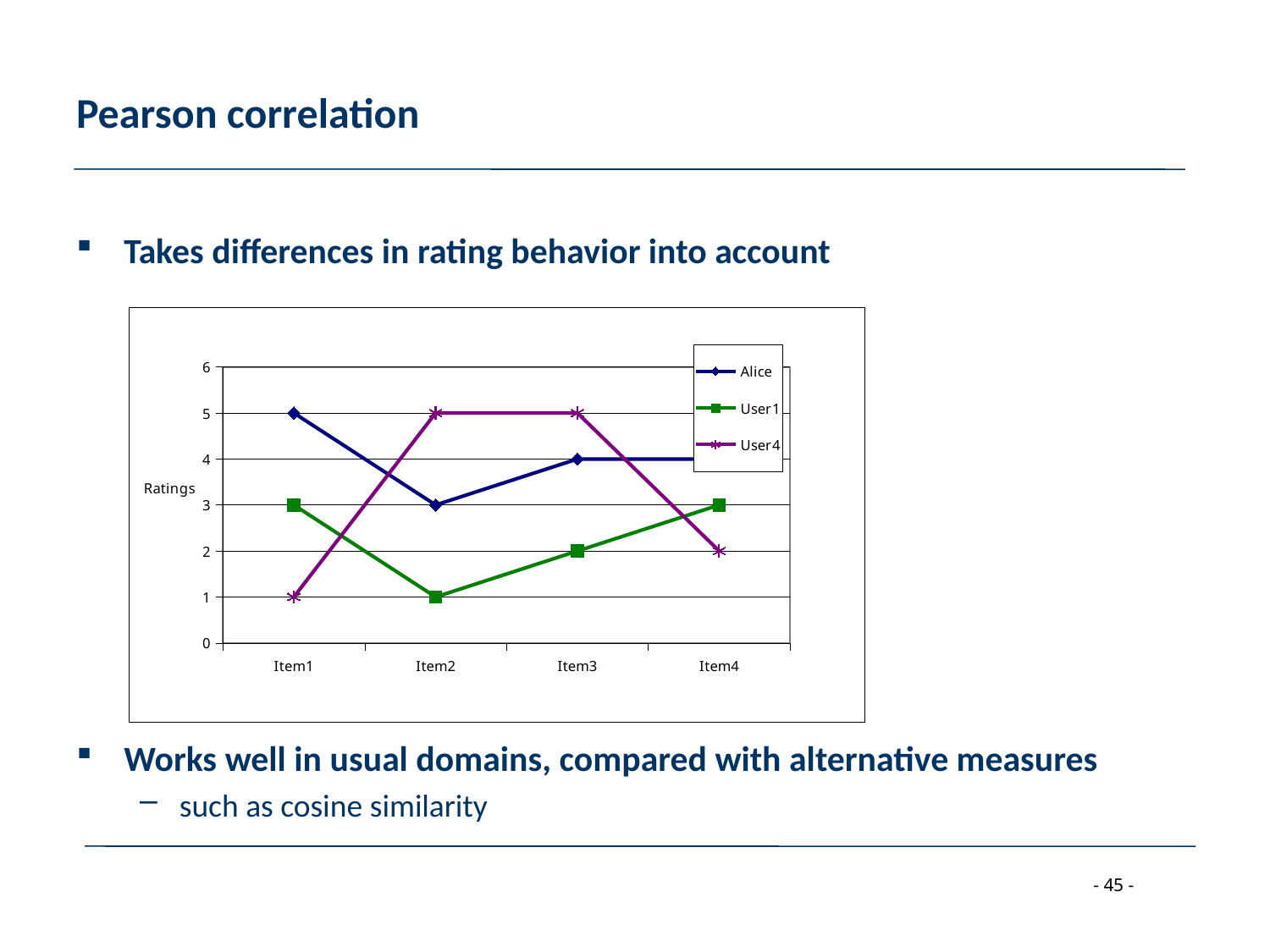
How many series does the legend list? 3 For which item does Alice give her lowest rating? Item2 For which item does User1 give the lowest rating? Item2 What is the difference between Alice's rating and User1's rating for Item3? 2 How many items are shown on the x axis? 4 Which is larger for Item2: User4's rating or Alice's rating? User4's rating What is User4's rating for Item4? 2 What is the label on the y axis? Ratings Do User1's ratings rise or fall from Item2 to Item4? rise What is Alice's rating for Item1? 5 What is User1's rating for Item2? 1 What kind of chart is shown on the slide? line chart